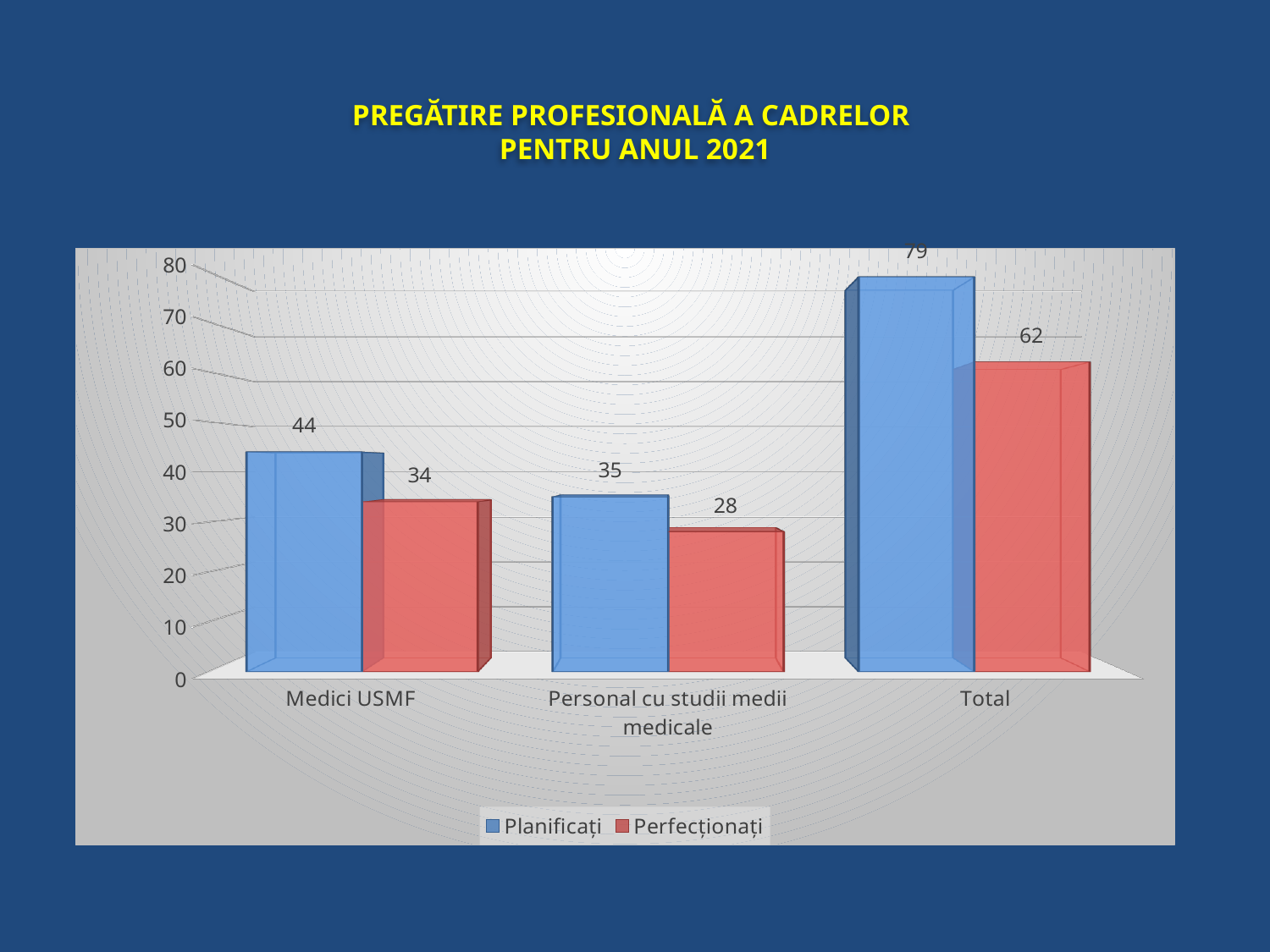
What is the Planificați value for Medici USMF? 44 What is the difference between Planificați and Perfecționați for Medici USMF? 10 Which category has the highest Planificați value? Total How many series does the legend list? 2 How many categories are shown on the x axis? 3 Which category has the lowest Perfecționați value? Personal cu studii medii medicale What is the difference between Planificați and Perfecționați for Total? 17 Which is larger for Personal cu studii medii medicale: Planificați or Perfecționați? Planificați What kind of chart is shown on the slide? Bar chart What is the Perfecționați value for Total? 62 What is the Perfecționați value for Personal cu studii medii medicale? 28 Which colour represents the Perfecționați series? Red